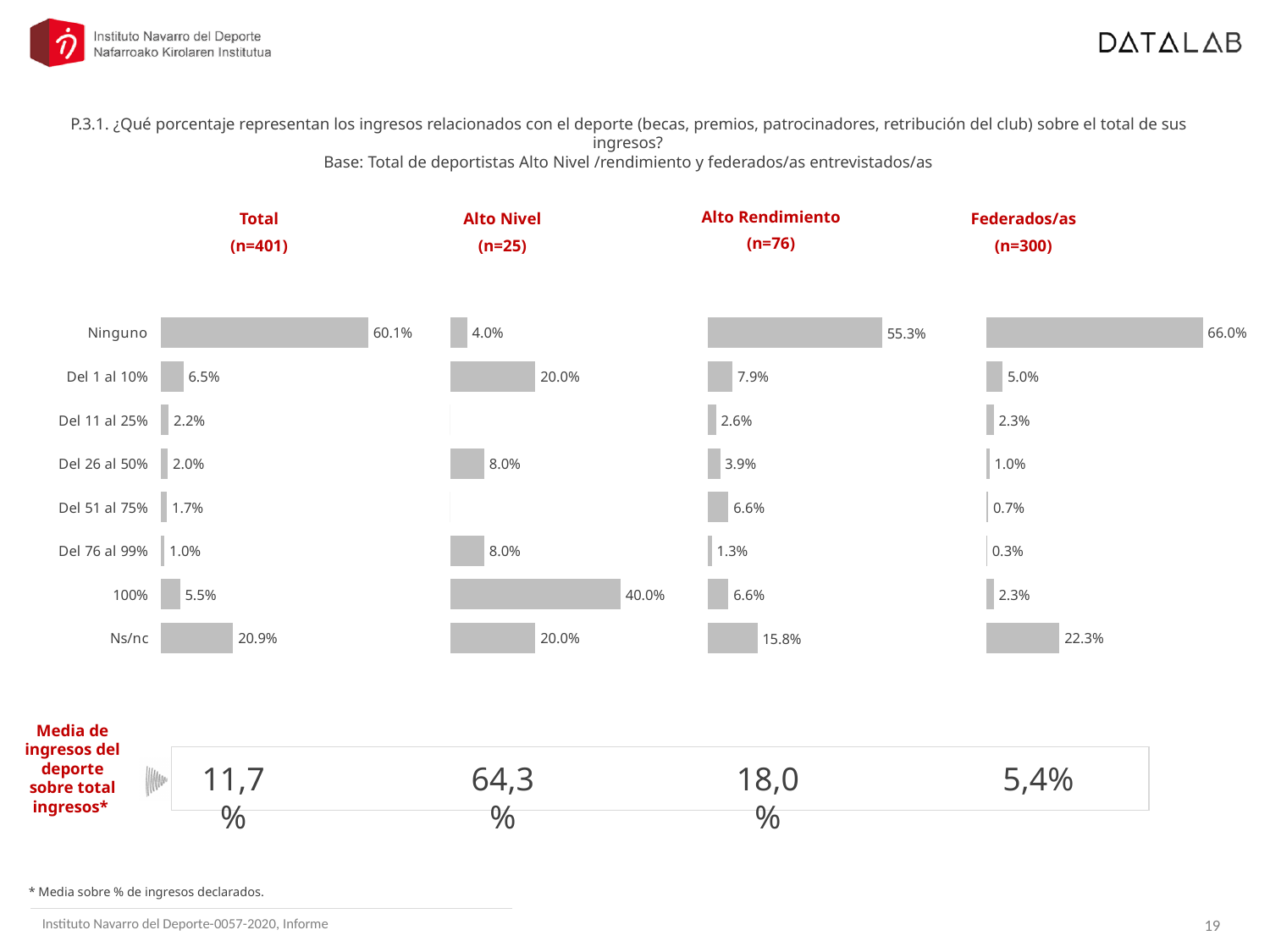
In the Alto Rendimiento (n=76) chart, what is the value for Ns/nc? 15.8% In the Total (n=401) chart, what is the value for Ninguno? 60.1% In the Total (n=401) chart, what is the difference between the values for Ninguno and Ns/nc? 39.2% In the Alto Nivel (n=25) chart, which category has the highest value? 100% In the Federados/as (n=300) chart, which category has the lowest value? Del 76 al 99% What is the sample size (n) shown for the Alto Rendimiento chart? n=76 In the Alto Rendimiento (n=76) chart, which is larger, the value for Del 1 al 10% or the value for Del 51 al 75%? Del 1 al 10% In the Federados/as (n=300) chart, what is the value for Del 1 al 10%? 5.0% What type of chart is used for the Federados/as (n=300) data? Bar chart In the Alto Nivel (n=25) chart, what is the value for 100%? 40.0% How many categories are shown in the Total (n=401) chart? 8 In the Alto Rendimiento (n=76) chart, what is the difference between the values for Ninguno and Del 1 al 10%? 47.4%